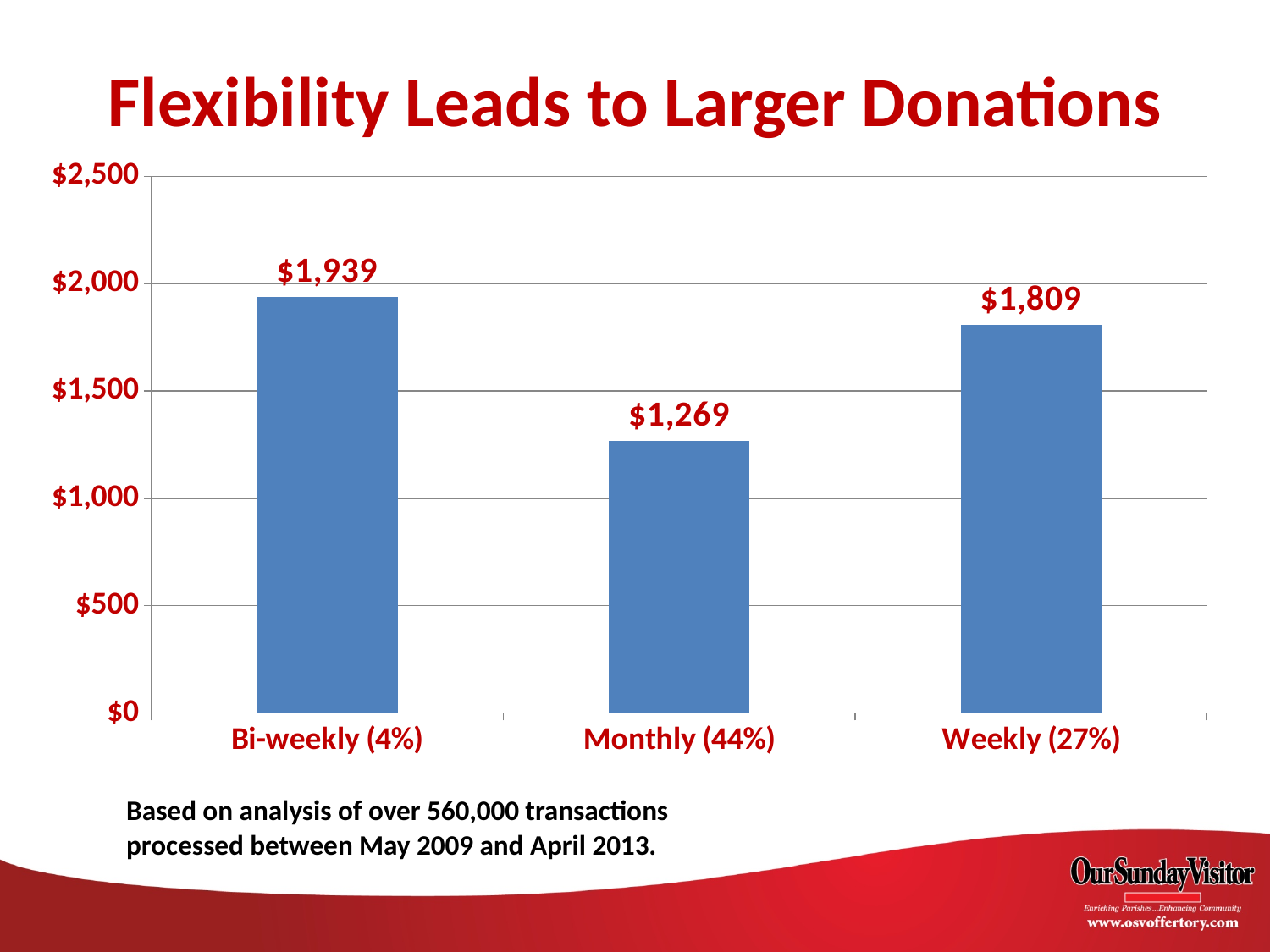
Which category has the highest value? Bi-weekly (4%) How many categories are shown on the chart? 3 What is the difference between the values for Bi-weekly (4%) and Weekly (27%)? $130 What is the value for Bi-weekly (4%)? $1,939 What kind of chart is shown on the slide? bar chart What is the value for Weekly (27%)? $1,809 Which is larger, the value for Monthly (44%) or the value for Weekly (27%)? Weekly (27%) Which category has the lowest value? Monthly (44%) What is the value for Monthly (44%)? $1,269 Is the value for Monthly (44%) greater or less than $1,500? less What is the title of the chart? Flexibility Leads to Larger Donations What is the difference between the values for Weekly (27%) and Monthly (44%)? $540